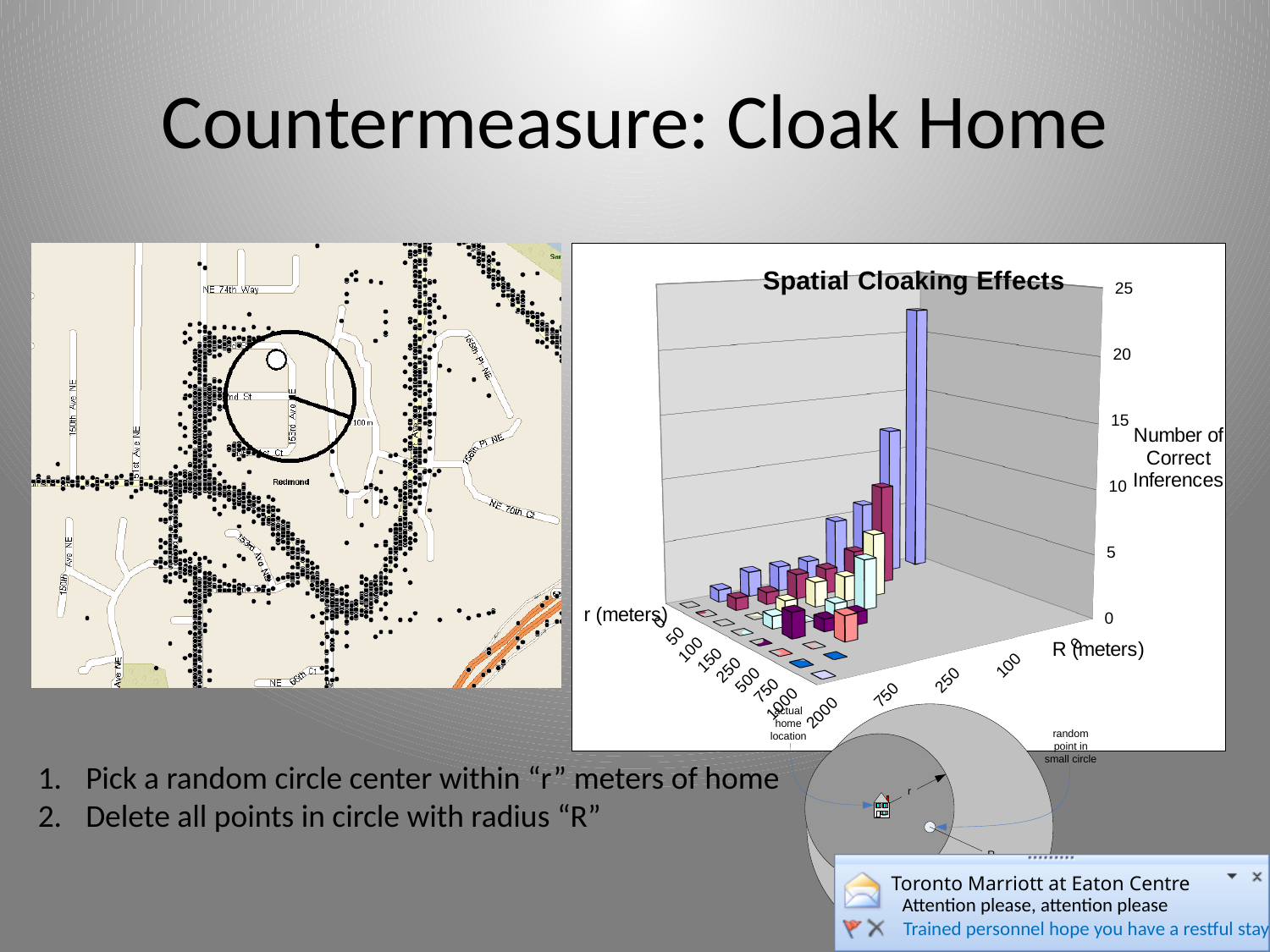
In the "Spatial Cloaking Effects" chart, do the number of correct inferences generally rise or fall as r (meters) increases? fall In the "Spatial Cloaking Effects" chart, what is the highest value shown on the vertical axis? 25 In the "Spatial Cloaking Effects" chart, is the bar at r = 2000 and R = 0 greater or less than 5? less In the "Spatial Cloaking Effects" chart, how many tick values are labelled along the r (meters) axis? 9 In the "Spatial Cloaking Effects" chart, is the tallest bar greater or less than 20? greater In the "Spatial Cloaking Effects" chart, what is the label of the vertical axis? Number of Correct Inferences In the "Spatial Cloaking Effects" chart, which bar is taller: the one at r = 0, R = 0 or the one at r = 50, R = 0? r = 0, R = 0 In the "Spatial Cloaking Effects" chart, what is the largest tick value labelled on the r (meters) axis? 2000 What kind of chart is the "Spatial Cloaking Effects" chart? bar chart What is the title of the chart on the right side of the slide? Spatial Cloaking Effects In the "Spatial Cloaking Effects" chart, at which r (meters) value does the tallest bar occur? 0